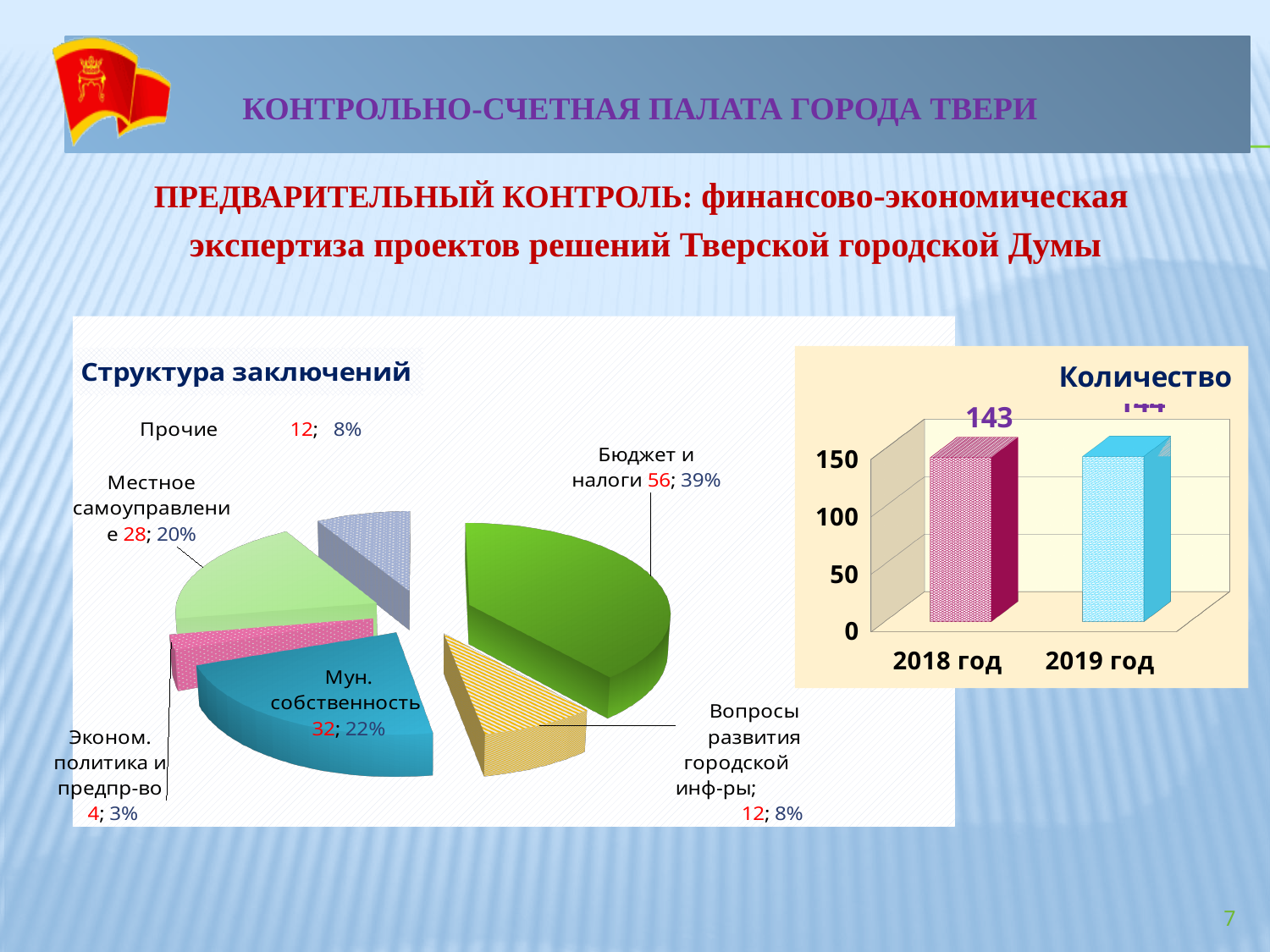
What kind of chart is the "Структура заключений" chart? pie chart In the "Структура заключений" pie chart, which is larger: "Мун. собственность" or "Местное самоуправление"? Мун. собственность What kind of chart is the "Количество" chart on the right? bar chart In the "Структура заключений" pie chart, which category has the largest value? Бюджет и налоги In the "Структура заключений" pie chart, what is the value for "Бюджет и налоги"? 56 How many bars does the "Количество" bar chart have? 2 In the "Структура заключений" pie chart, what is the difference between the values for "Бюджет и налоги" and "Мун. собственность"? 24 How many slices does the "Структура заключений" pie chart have? 6 In the "Структура заключений" pie chart, what share does "Бюджет и налоги" have? 39% In the "Количество" bar chart, is the value for "2019 год" greater or less than 100? greater In the "Структура заключений" pie chart, which category has the smallest value? Эконом. политика и предпр-во In the "Количество" bar chart, what is the value for "2018 год"? 143